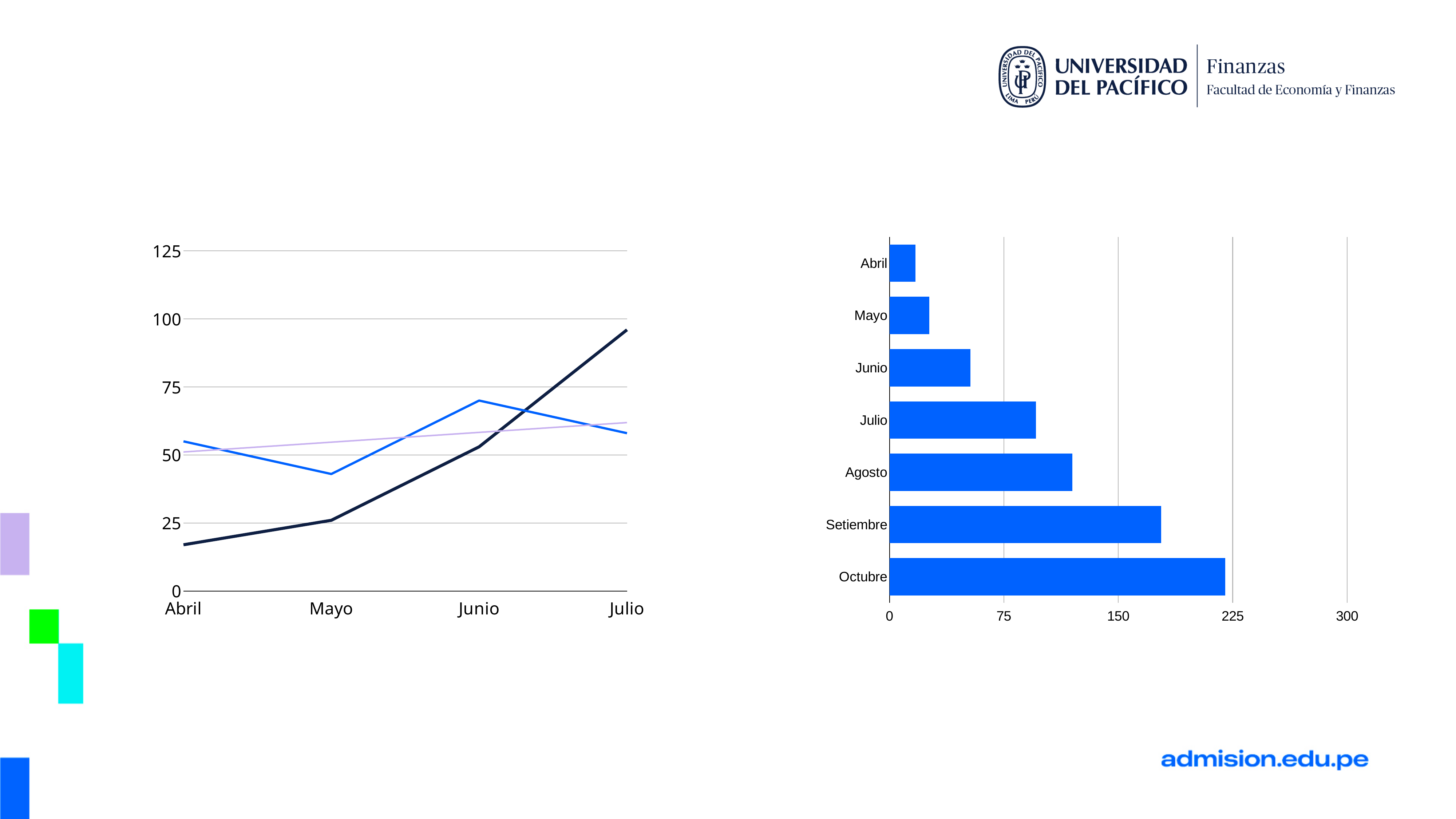
In the bar chart on the right, which month has the longest bar? Octubre What kind of chart is the chart on the left side of the slide? line chart In the bar chart on the right, is the value for Junio greater or less than 75? less In the bar chart on the right, is the value for Agosto greater or less than 150? less In the bar chart on the right, how many months are shown? 7 In the line chart on the left, how many lines are plotted? 3 In the bar chart on the right, is the value for Setiembre greater or less than 150? greater In the line chart on the left, does the dark navy line rise or fall from Abril to Julio? rise In the bar chart on the right, which is larger, the value for Agosto or the value for Julio? Agosto In the line chart on the left, how many months are shown on the x axis? 4 In the bar chart on the right, which month has the shortest bar? Abril What kind of chart is the chart on the right side of the slide? bar chart